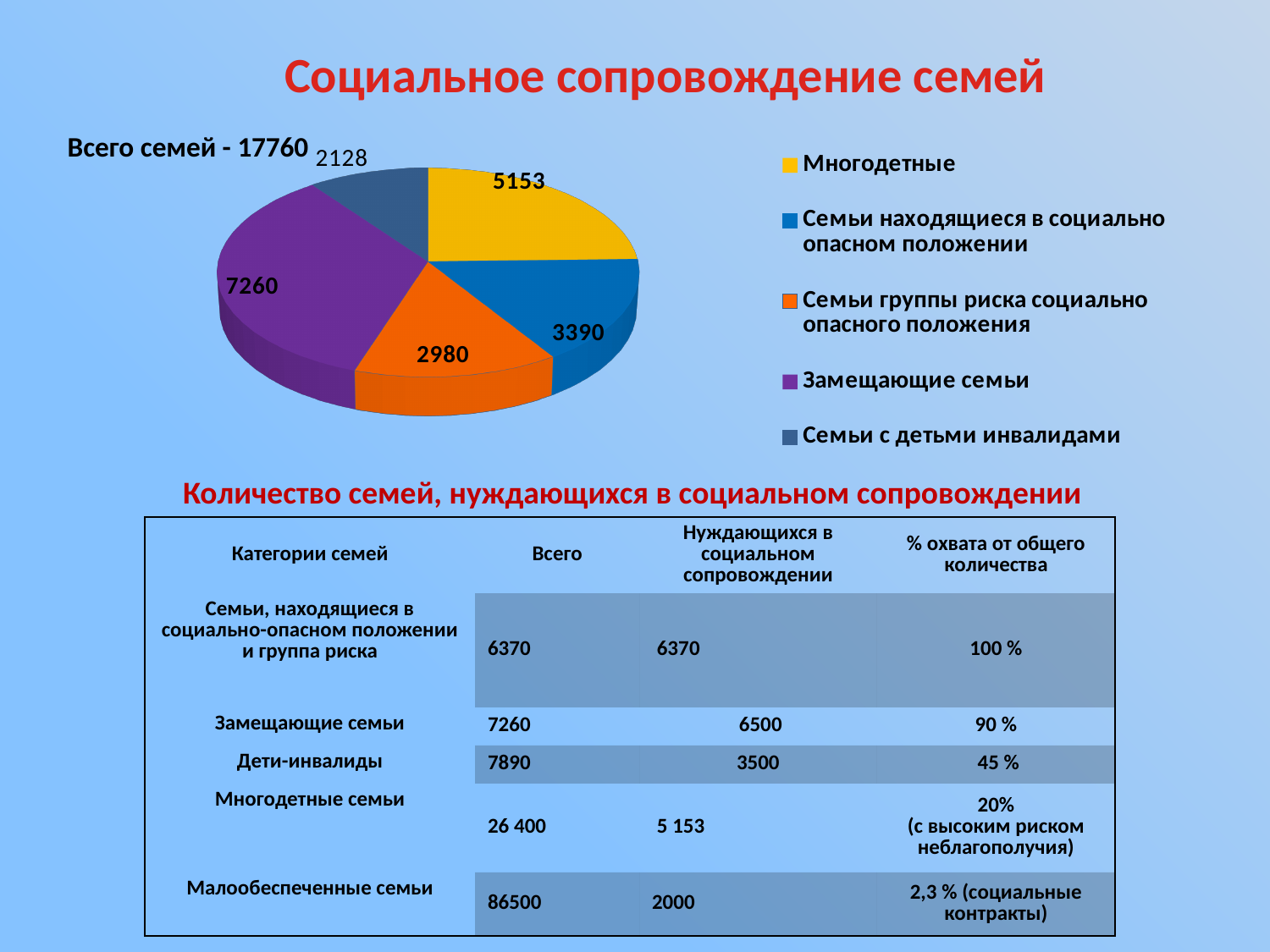
Which category has the largest slice in the pie chart? Замещающие семьи Which category has the smallest slice in the pie chart? Семьи с детьми инвалидами What colour is the slice for Замещающие семьи in the pie chart? purple What is the value for Замещающие семьи in the pie chart? 7260 What is the difference between the values for Замещающие семьи and Многодетные in the pie chart? 2107 What is the value for Семьи группы риска социально опасного положения in the pie chart? 2980 How many slices does the pie chart have? 5 What type of chart is shown on the slide? pie chart What is the value for Многодетные in the pie chart? 5153 What is the value for Семьи находящиеся в социально опасном положении in the pie chart? 3390 Which is larger in the pie chart: Семьи находящиеся в социально опасном положении or Семьи группы риска социально опасного положения? Семьи находящиеся в социально опасном положении What is the value for Семьи с детьми инвалидами in the pie chart? 2128